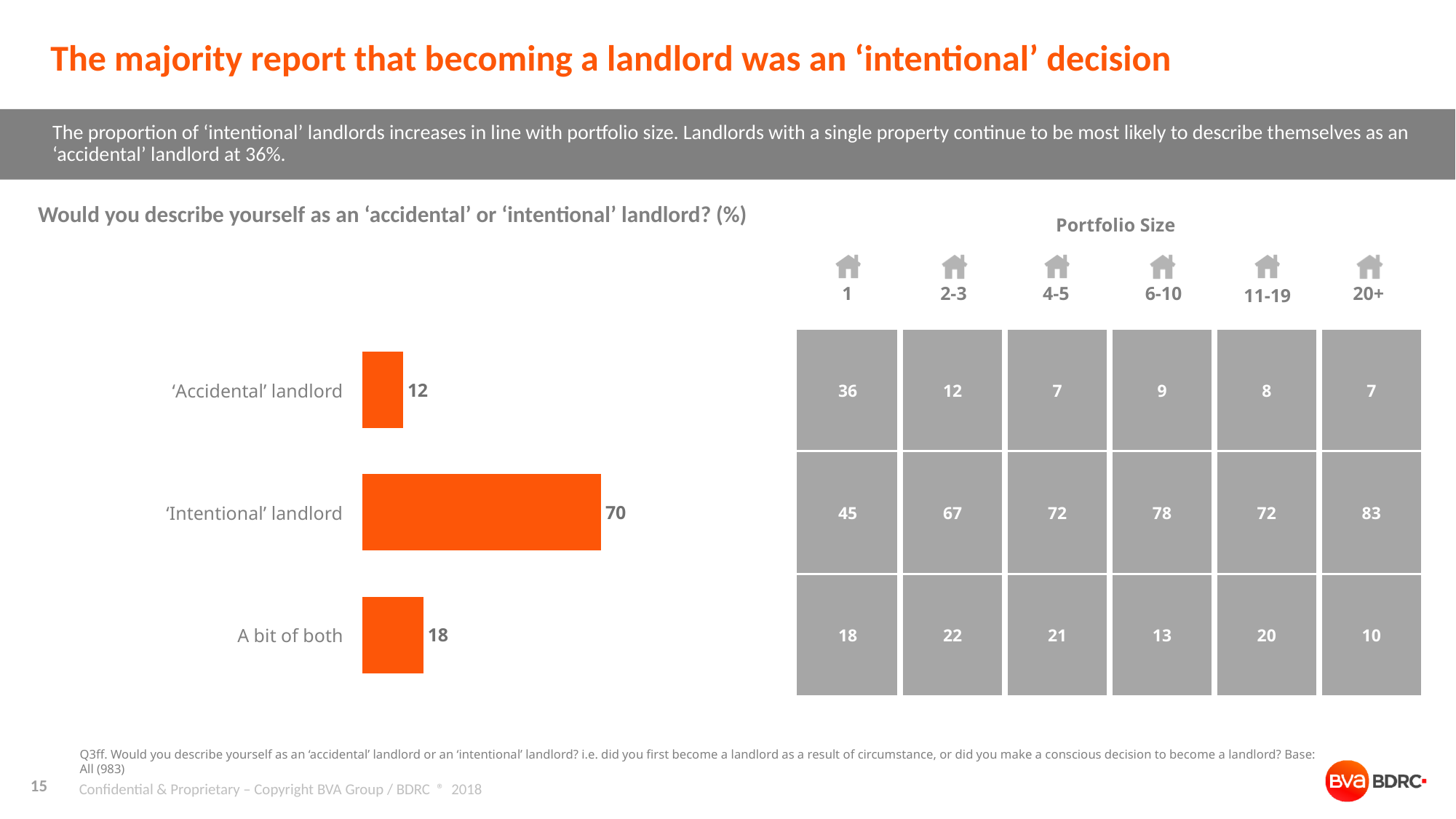
What is the value for 'A bit of both' in the bar chart? 18 Which category has the highest value in the bar chart? 'Intentional' landlord Which category has the lowest value in the bar chart? 'Accidental' landlord In the Portfolio Size table, what is the 'Accidental' landlord value for landlords with 1 property? 36 What is the value for 'Intentional' landlord in the bar chart? 70 In the Portfolio Size table, which portfolio size has the highest 'Intentional' landlord value? 20+ What is the difference between the 'Intentional' landlord and 'Accidental' landlord values in the bar chart? 58 What colour are the bars in the bar chart? Orange How many categories are shown in the bar chart? 3 What is the value for 'Accidental' landlord in the bar chart? 12 What kind of chart is used to show the accidental/intentional landlord results? Bar chart Which is larger in the bar chart: 'A bit of both' or 'Accidental' landlord? A bit of both